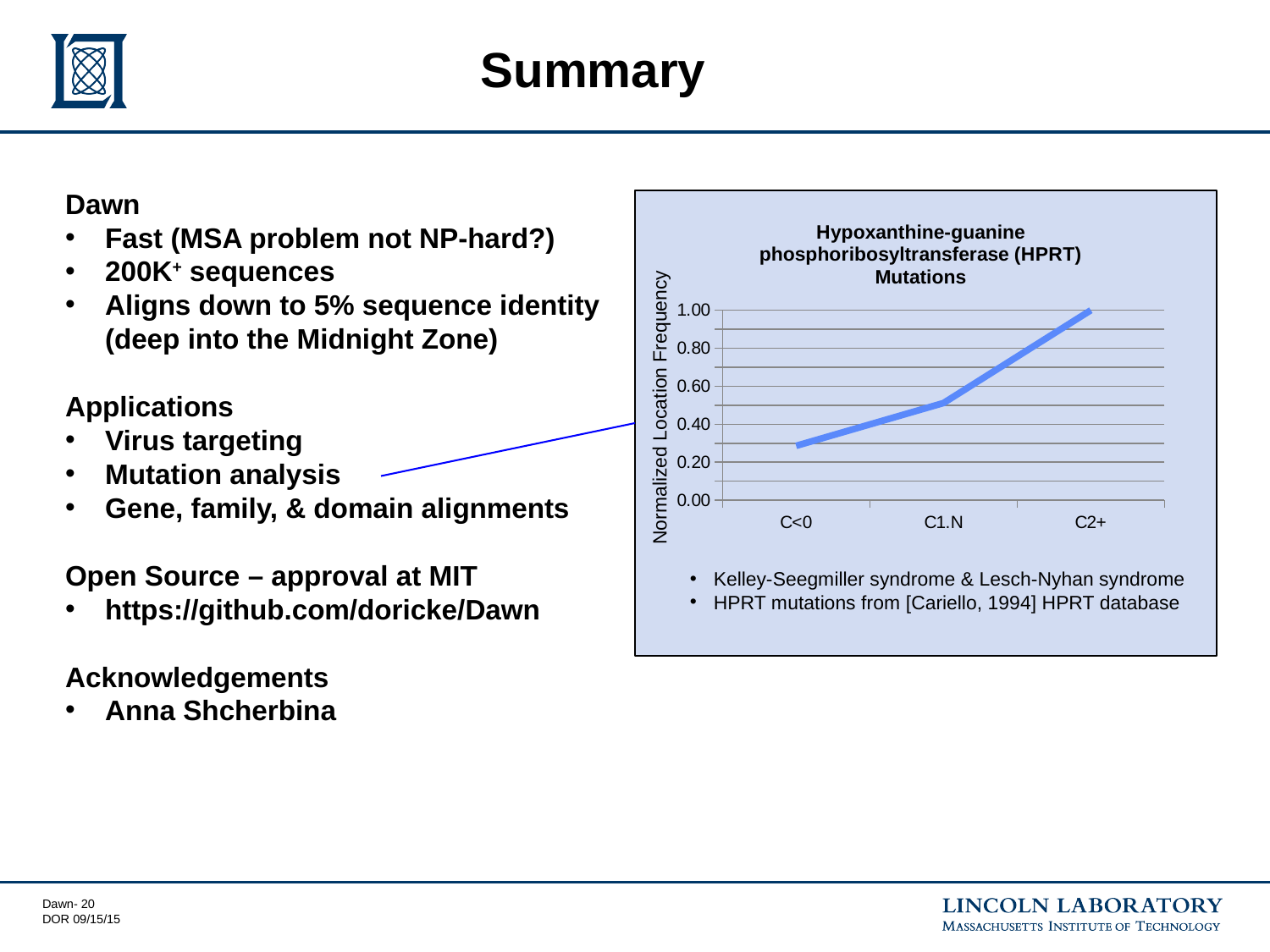
Is the value for C<0 greater or less than 0.20? greater What type of chart is shown on the slide? line chart How many categories are shown on the x-axis of the chart? 3 Which category has the highest Normalized Location Frequency? C2+ Do the values rise or fall from C<0 to C2+? rise What is the label of the y-axis of the chart? Normalized Location Frequency Is the value for C2+ greater or less than 0.80? greater Which category has the lowest Normalized Location Frequency? C<0 Is the value for C1.N greater or less than 0.40? greater Which is larger, the value for C1.N or the value for C2+? C2+ What is the title of the chart? Hypoxanthine-guanine phosphoribosyltransferase (HPRT) Mutations